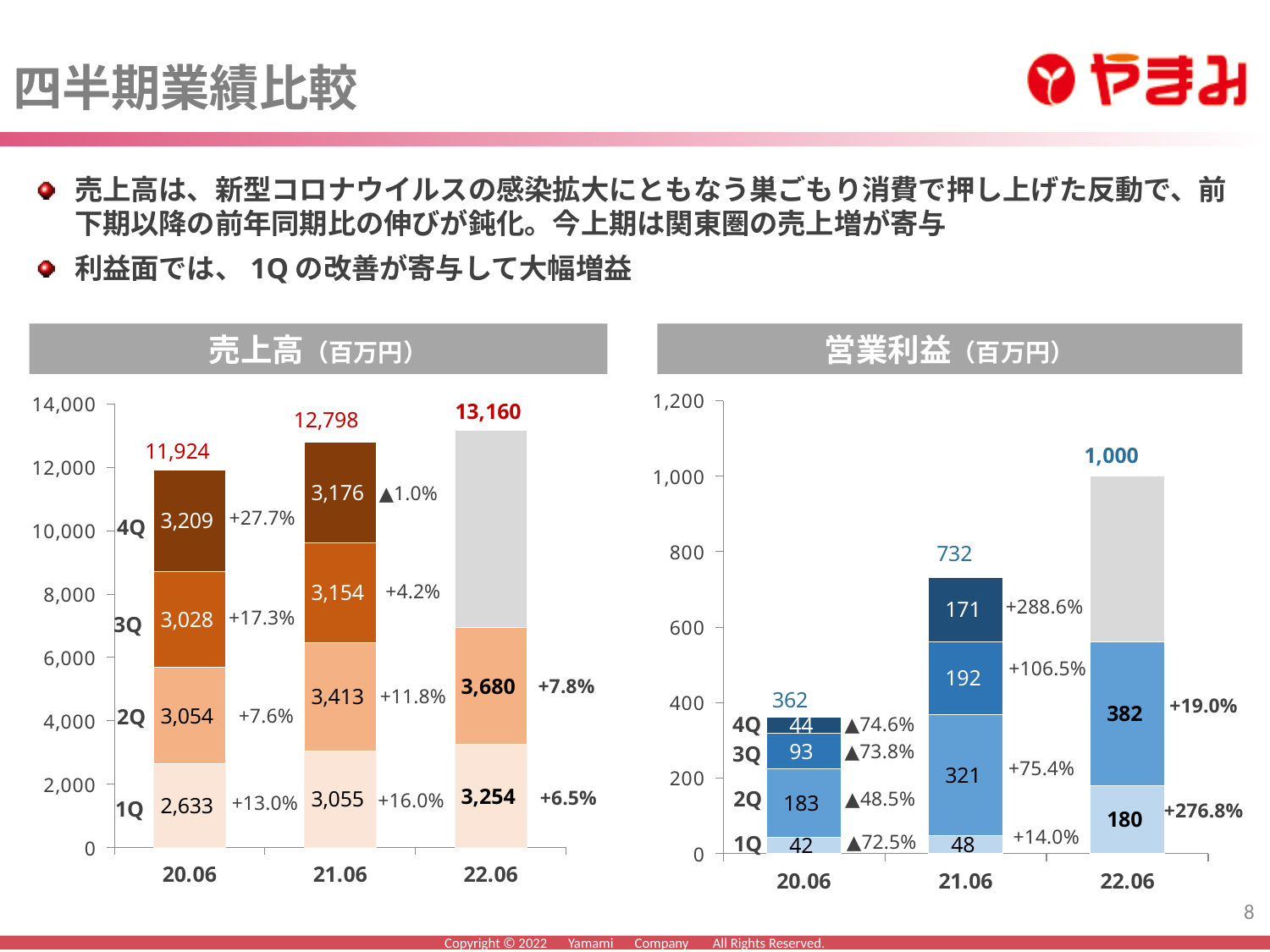
In the 営業利益 (百万円) chart, what is the 2Q value for 21.06? 321 In the 営業利益 (百万円) chart, what is the difference between the 4Q values for 21.06 and 20.06? 127 In the 営業利益 (百万円) chart, what is the total shown above the 22.06 bar? 1,000 In the 売上高 (百万円) chart, what is the total shown above the 20.06 bar? 11,924 In the 営業利益 (百万円) chart, is the 1Q value for 22.06 larger or smaller than the 1Q value for 21.06? larger How many years are shown on the x axis of the 売上高 (百万円) chart? 3 In the 売上高 (百万円) chart, what year-on-year change is shown next to the 2Q segment of 22.06? +7.8% What type of chart is the 営業利益 (百万円) chart? Stacked bar chart In the 売上高 (百万円) chart, what is the difference between the 1Q values for 22.06 and 21.06? 199 In the 売上高 (百万円) chart, which year has the highest total? 22.06 In the 売上高 (百万円) chart, what is the 2Q value for 21.06? 3,413 In the 営業利益 (百万円) chart, which year has the lowest total? 20.06